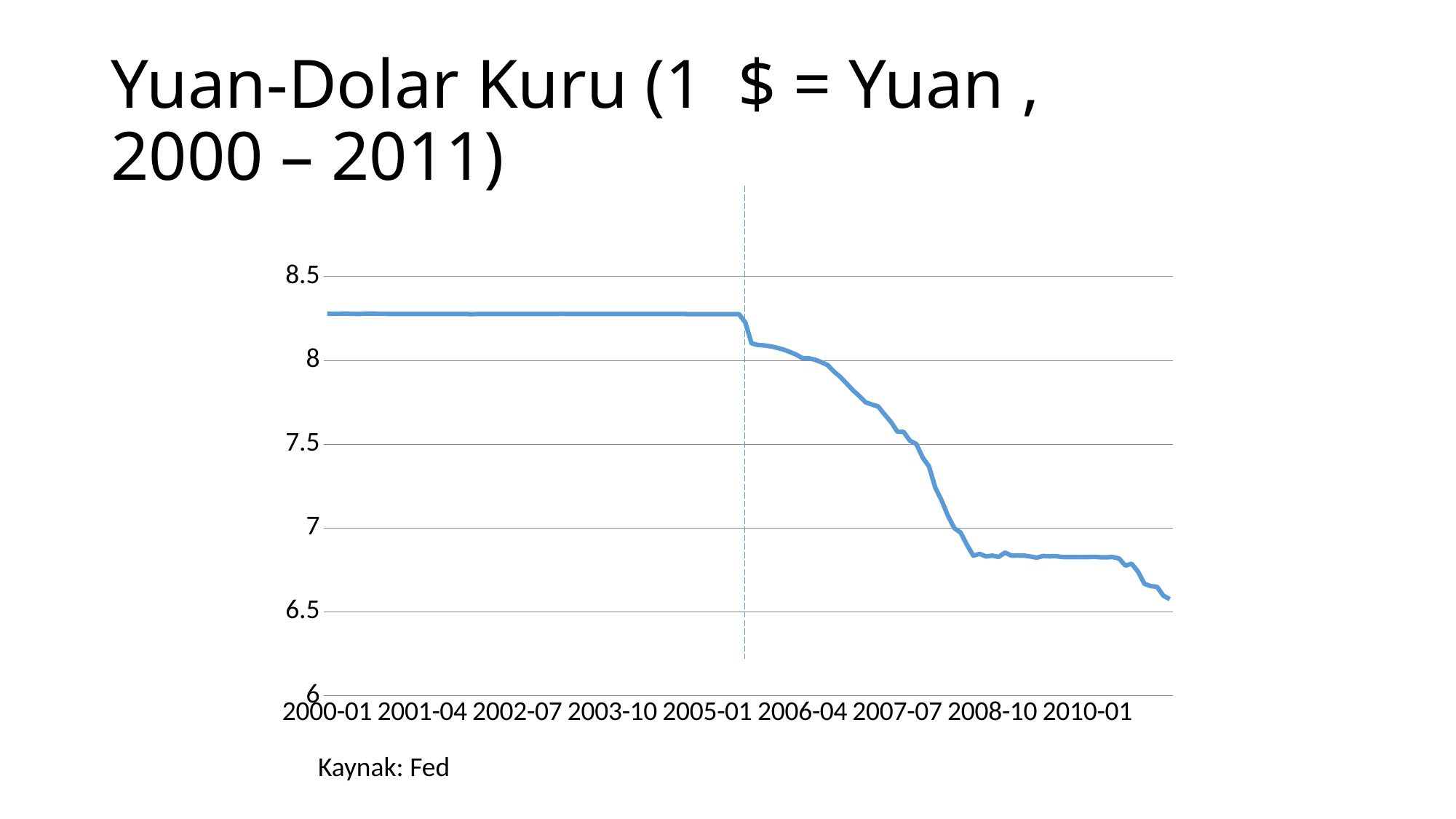
What source is cited below the chart? Kaynak: Fed How many date labels are shown on the x axis? 9 Is the value for 2007-07 greater or less than 8? less Is the value for 2008-10 greater or less than 7? less What is the highest value shown on the y axis? 8.5 Which is larger, the value for 2000-01 or the value for 2010-01? 2000-01 Is the value for 2010-01 greater or less than 7? less Does the Yuan-Dollar rate rise or fall over the period shown on the chart? fall What kind of chart is shown on the slide? line chart